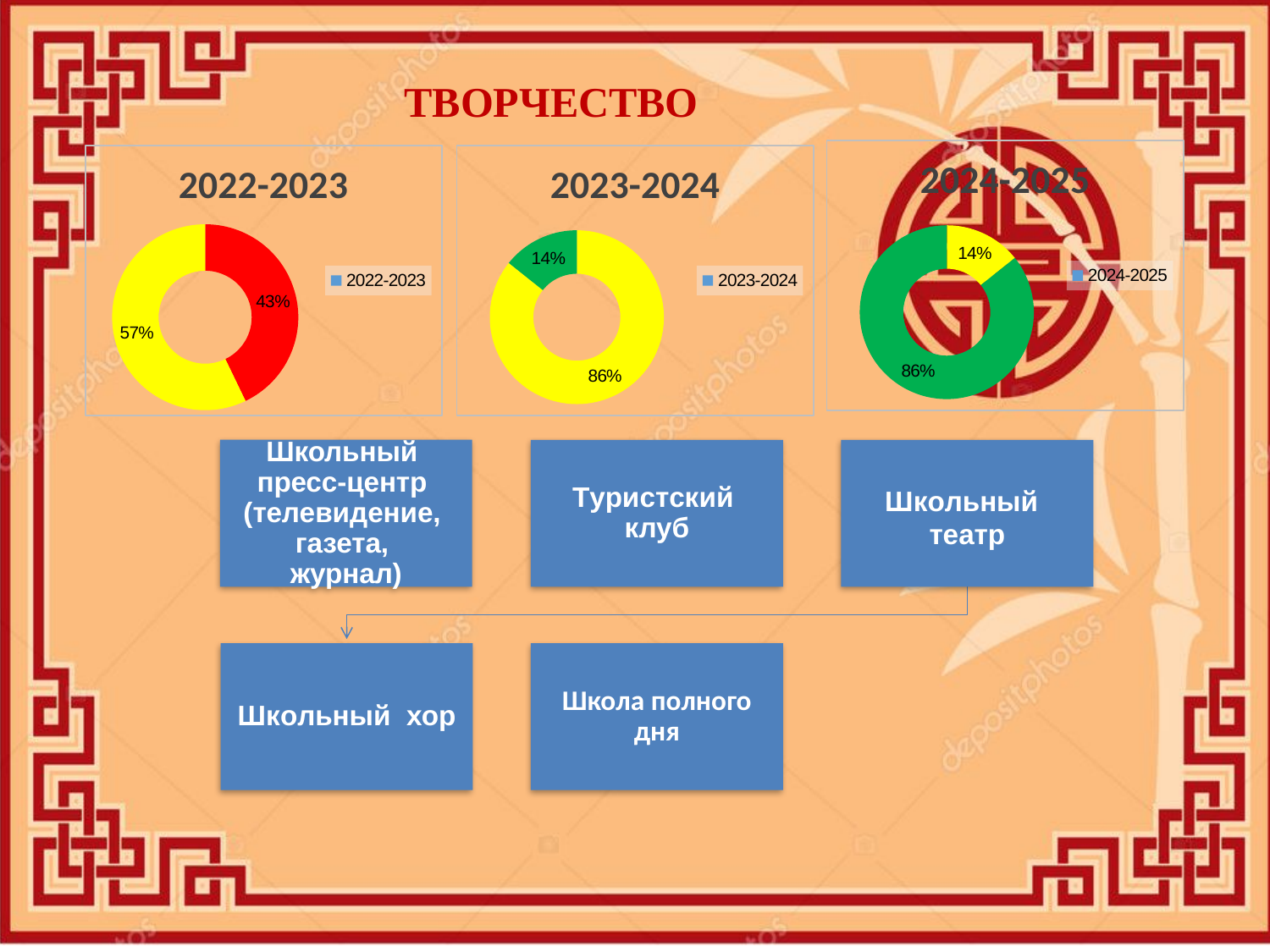
In the 2022-2023 chart, what is the difference in percentage points between the yellow slice and the red slice? 14 How many slices does the 2024-2025 chart have? 2 In the 2022-2023 chart, what percentage is shown for the yellow slice? 57% In the 2023-2024 chart, what is the difference in percentage points between the yellow slice and the green slice? 72 In the 2024-2025 chart, what percentage is shown for the green slice? 86% How many entries does the legend of the 2023-2024 chart list? 1 In the 2024-2025 chart, which colour slice is the smallest? yellow In the 2022-2023 chart, which slice is larger, the yellow one or the red one? yellow What type of chart is the 2022-2023 chart? doughnut chart In the 2023-2024 chart, what percentage is shown for the green slice? 14% In the 2023-2024 chart, which colour slice is the largest? yellow In the 2022-2023 chart, what percentage is shown for the red slice? 43%